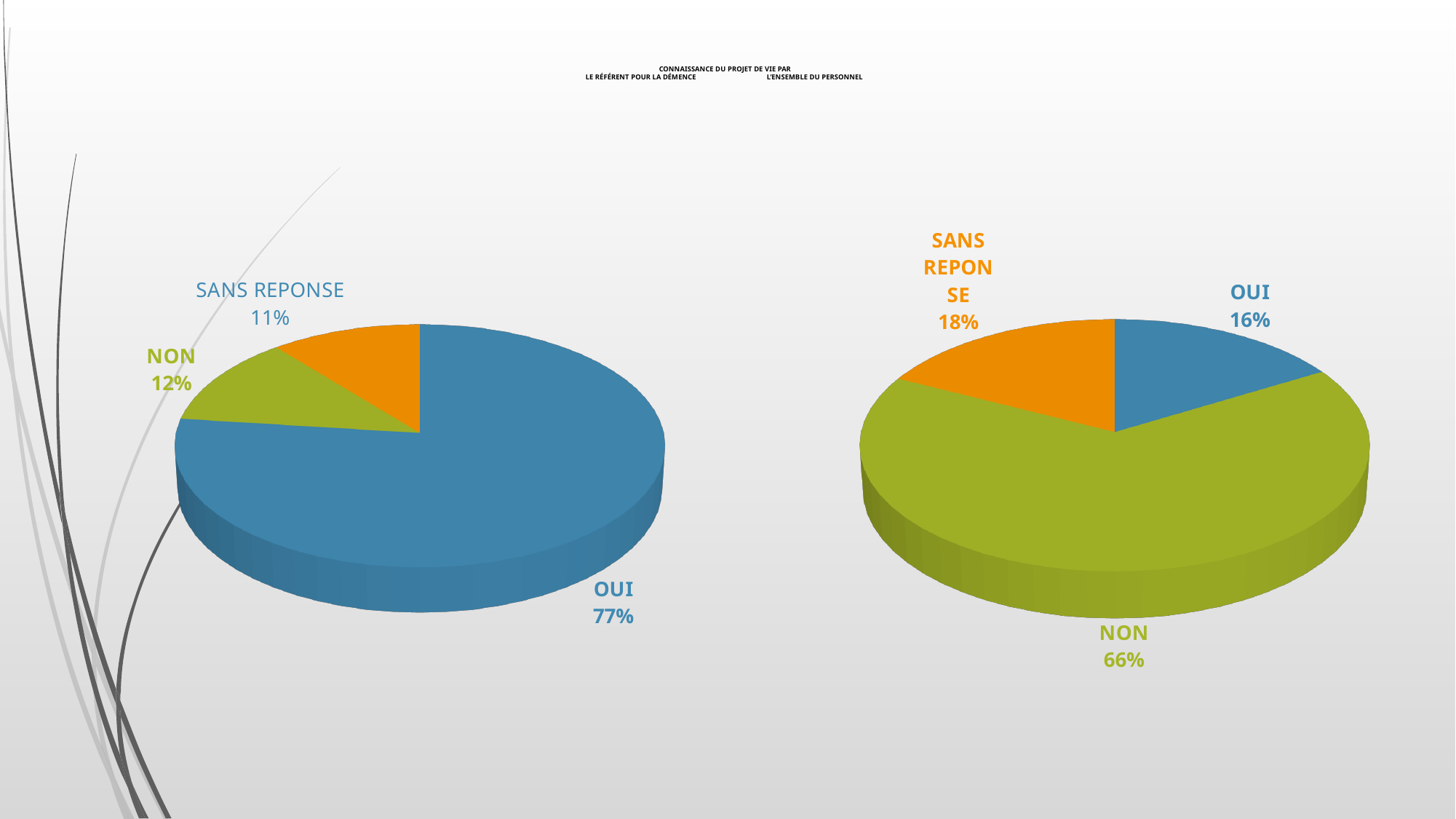
In the right pie chart (l'ensemble du personnel), which is larger, SANS REPONSE or OUI? SANS REPONSE In the right pie chart (l'ensemble du personnel), what is the share for OUI? 16% In the right pie chart (l'ensemble du personnel), what is the share for SANS REPONSE? 18% What type of chart is shown on the left of the slide? Pie chart In the left pie chart (le référent pour la démence), what is the share for SANS REPONSE? 11% How many slices does the right pie chart (l'ensemble du personnel) have? 3 In the left pie chart (le référent pour la démence), which category has the largest slice? OUI In the right pie chart (l'ensemble du personnel), what is the share for NON? 66% In the right pie chart (l'ensemble du personnel), which category has the smallest slice? OUI In the left pie chart (le référent pour la démence), what is the difference between the OUI and NON shares? 65% In the left pie chart (le référent pour la démence), what is the share for OUI? 77% In the left pie chart (le référent pour la démence), what is the share for NON? 12%